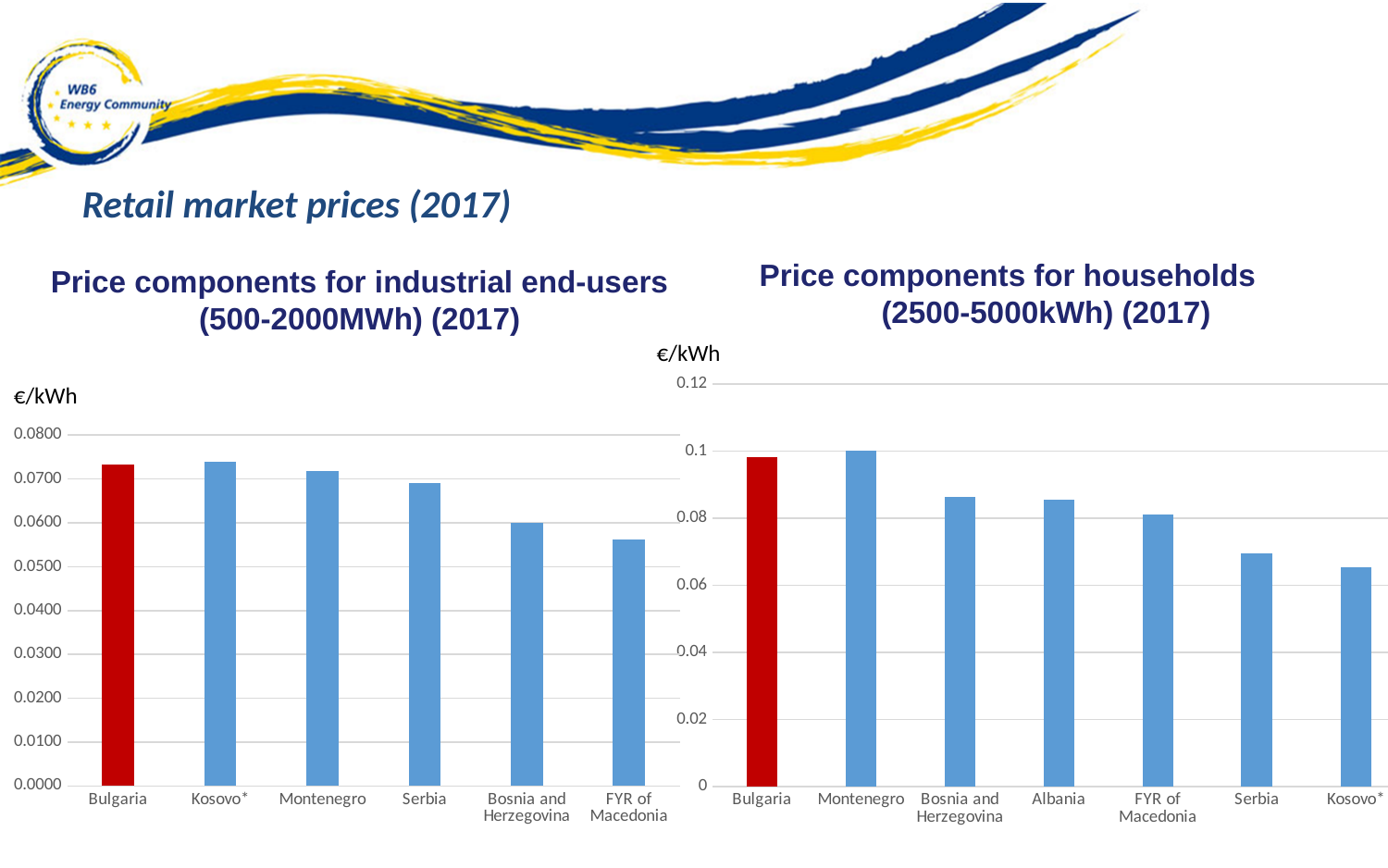
On the 'Price components for industrial end-users' chart, is the value for Bosnia and Herzegovina greater or less than 0.0700? less On the 'Price components for households' chart, which country's bar is coloured red? Bulgaria On the 'Price components for households' chart, which is larger, the value for Montenegro or the value for Kosovo*? Montenegro On the 'Price components for industrial end-users' chart, which is larger, the value for Serbia or the value for FYR of Macedonia? Serbia On the 'Price components for industrial end-users' chart, is the value for Bulgaria greater or less than 0.0700? greater What unit is shown on the vertical axis of the 'Price components for households' chart? €/kWh On the 'Price components for industrial end-users' chart, which country has the lowest value? FYR of Macedonia On the 'Price components for households' chart, is the value for Serbia greater or less than 0.08? less What type of chart is the 'Price components for industrial end-users' chart? bar chart How many countries are shown on the 'Price components for households' chart? 7 How many countries are shown on the 'Price components for industrial end-users' chart? 6